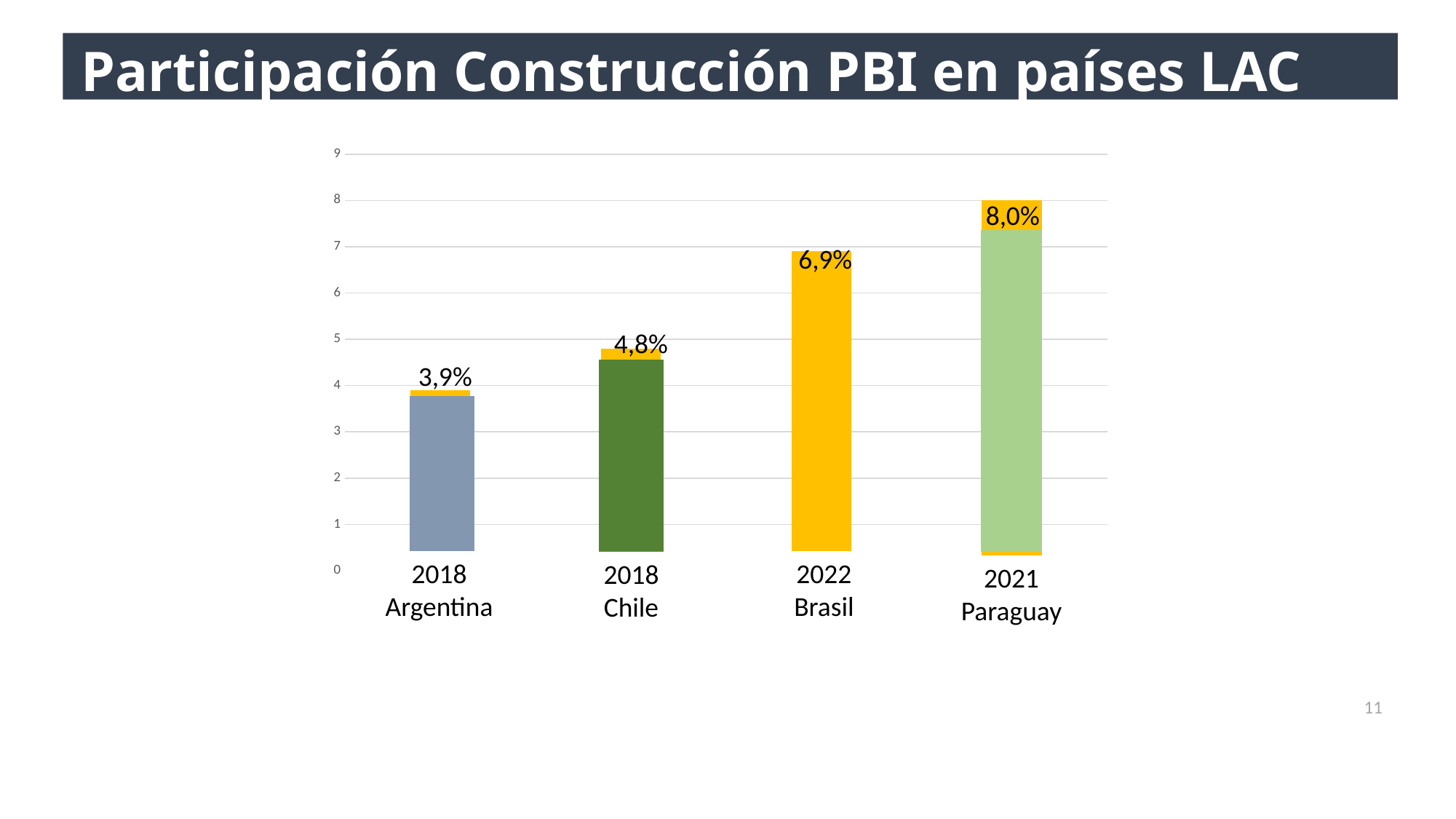
What is the title of the slide? Participación Construcción PBI en países LAC Which is larger, the value for 2022 Brasil or the value for 2018 Chile? 2022 Brasil What kind of chart is shown on the slide? bar chart What is the value shown for 2021 Paraguay? 8,0% Which category has the highest value? 2021 Paraguay Which category has the lowest value? 2018 Argentina What is the value shown for 2022 Brasil? 6,9% What is the difference between the values for 2021 Paraguay and 2018 Argentina? 4,1% How many categories are shown in the chart? 4 What is the difference between the values for 2022 Brasil and 2018 Chile? 2,1% What is the value shown for 2018 Argentina? 3,9% What is the value shown for 2018 Chile? 4,8%